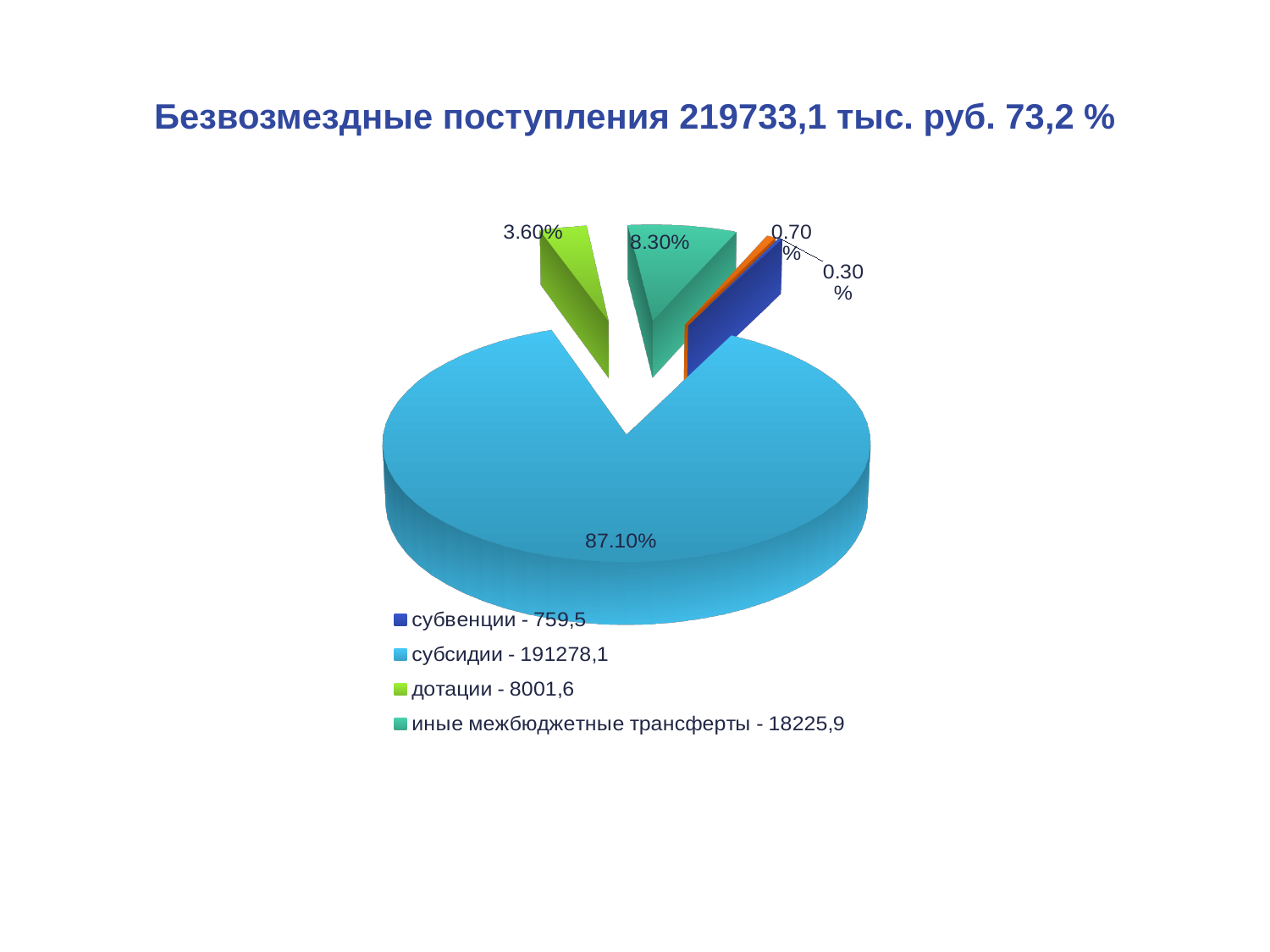
What value is given for иные межбюджетные трансферты in the legend? 18225,9 Which category has the largest slice of the pie? субсидии How many entries does the chart legend list? 4 What is the title of the chart on the slide? Безвозмездные поступления 219733,1 тыс. руб. 73,2 % What share of the pie is labelled for дотации (the light green slice)? 3.60% What share of the pie is labelled for иные межбюджетные трансферты (the teal slice)? 8.30% What share of the pie does the largest slice (субсидии) take? 87.10% What value is given for субсидии in the legend? 191278,1 What kind of chart is shown on the slide? pie chart What value is given for субвенции in the legend? 759,5 What is the difference in percentage points between the иные межбюджетные трансферты slice (8.30%) and the дотации slice (3.60%)? 4.70% Which slice is larger: дотации or иные межбюджетные трансферты? иные межбюджетные трансферты